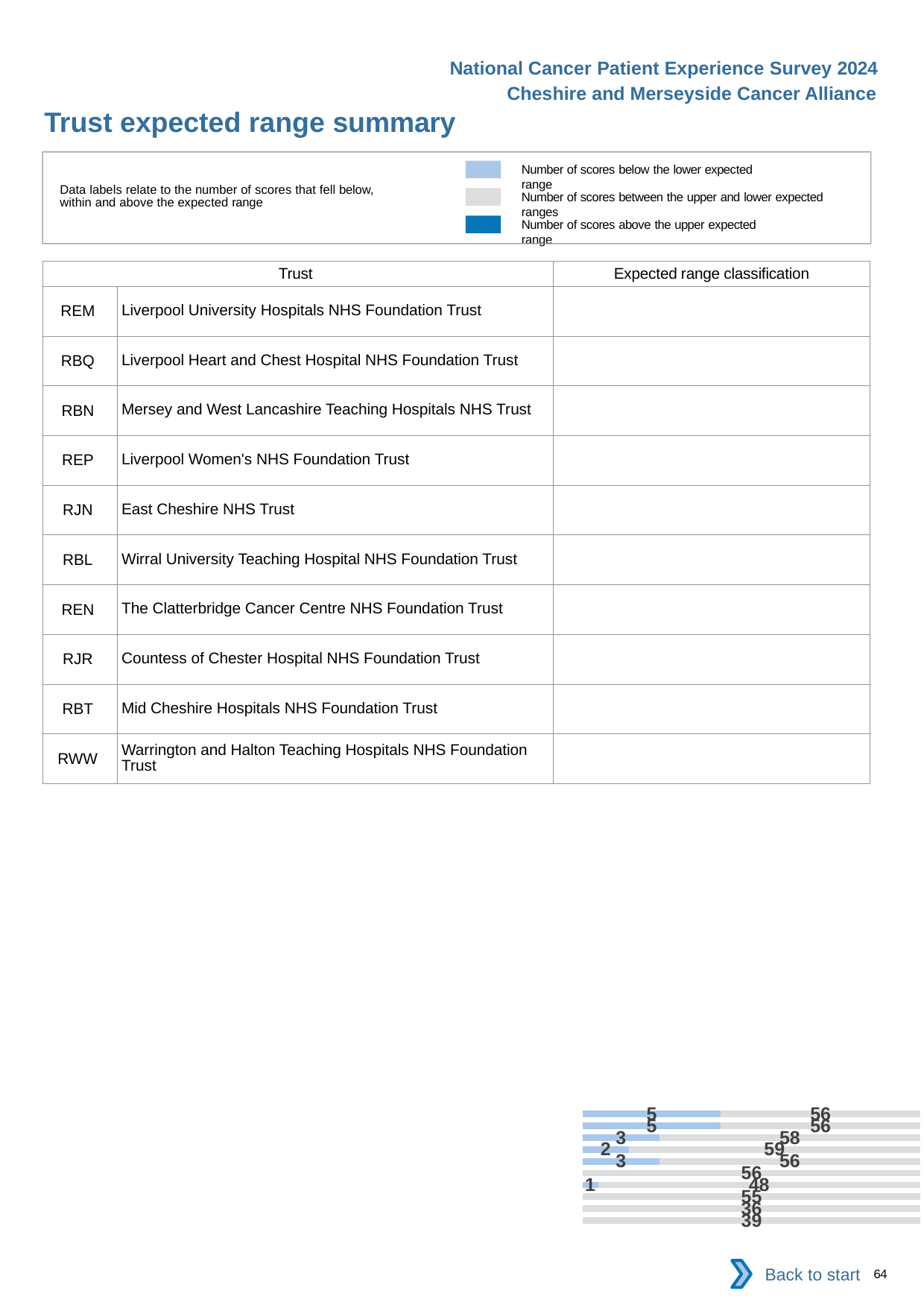
In the stacked bar chart at the bottom right, what is the total of the labelled segments on the topmost bar? 61 In the stacked bar chart at the bottom right, what is the grey data label on the topmost bar? 56 In the stacked bar chart at the bottom right, is the grey label on the topmost bar (56) larger or smaller than the label on the bottommost bar (39)? larger How many bars does the stacked bar chart at the bottom right of the slide contain? 10 In the stacked bar chart at the bottom right, what is the light blue data label on the topmost bar? 5 What kind of chart is shown at the bottom right of the slide? bar chart In the stacked bar chart at the bottom right, what is the smallest light blue data label shown? 1 In the stacked bar chart at the bottom right, what is the largest grey-segment data label shown? 59 How many colour categories does the legend box at the top of the slide list? 3 In the legend box, what does the light blue colour represent? Number of scores below the lower expected range In the stacked bar chart at the bottom right, what is the data label on the bottommost bar? 39 In the legend box, what does the dark blue colour represent? Number of scores above the upper expected range